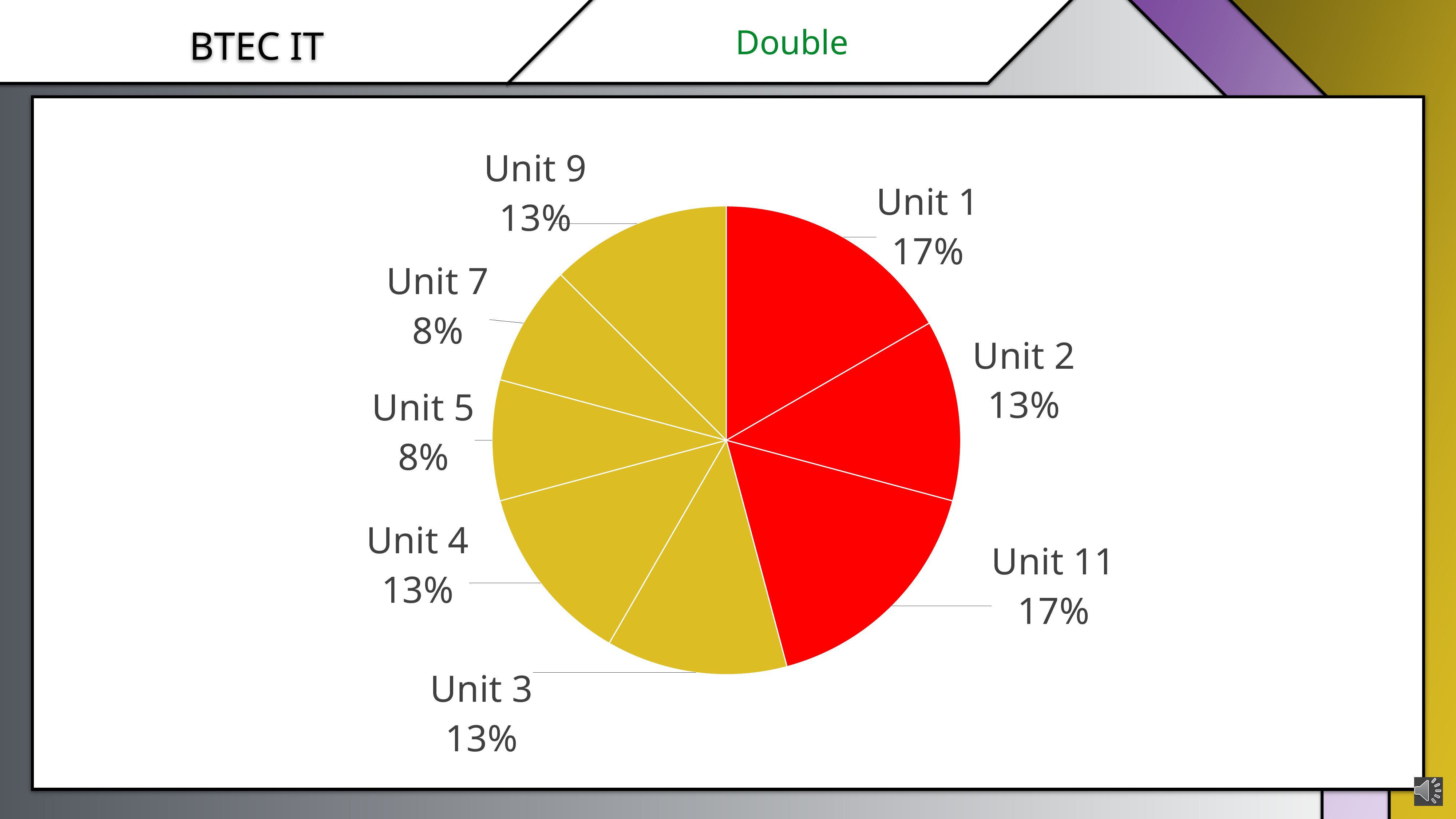
What percentage share does Unit 4 have in the pie chart? 13% Which two units have the smallest share of the pie chart? Unit 5 and Unit 7 What is the combined share of Unit 5 and Unit 7? 16% What percentage share does Unit 11 have in the pie chart? 17% How many slices does the pie chart have? 8 What type of chart is shown on the slide? Pie chart What is the largest percentage shown on the pie chart? 17% Which units are shown in red on the pie chart? Unit 1, Unit 2 and Unit 11 What is the difference in percentage points between Unit 1 and Unit 5? 9 What percentage share does Unit 1 have in the pie chart? 17% Which has a larger share, Unit 2 or Unit 7? Unit 2 What percentage share does Unit 7 have in the pie chart? 8%